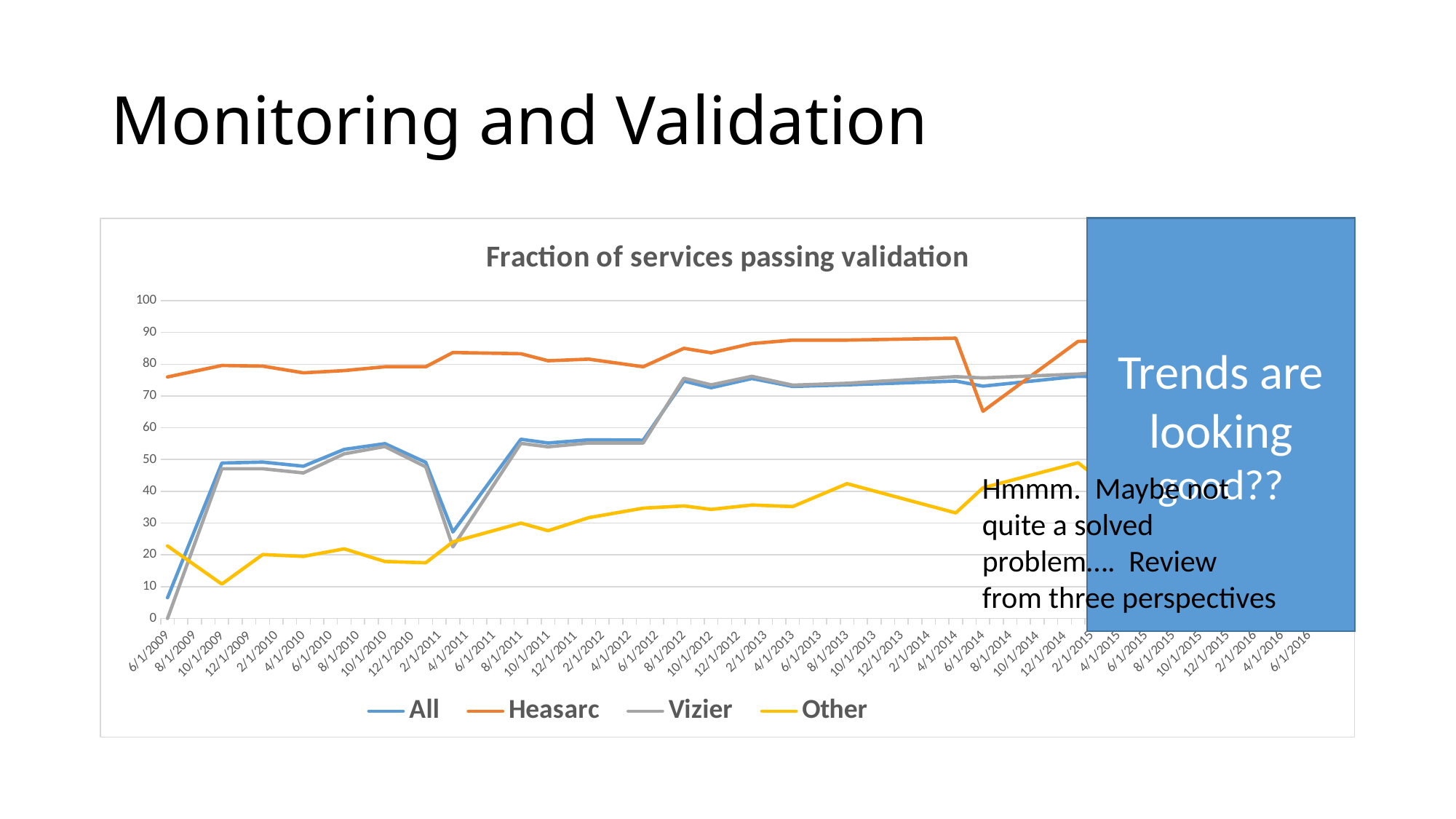
Which colour is used for the Heasarc series in the chart? orange How many series does the legend of the chart list? 4 Does the Heasarc series rise or fall between 4/1/2014 and 6/1/2014? fall Is the value for Heasarc at 6/1/2014 greater or less than 70? less At 6/1/2012, which is larger: the value for Heasarc or the value for Other? Heasarc Is the value for Vizier at 8/1/2012 greater or less than 70? greater Which series has the lowest value at 2/1/2015? Other Is the value for Other at 10/1/2009 greater or less than 20? less What kind of chart is shown on the slide? line chart Which series has the highest value at 6/1/2009? Heasarc What is the title of the chart? Fraction of services passing validation